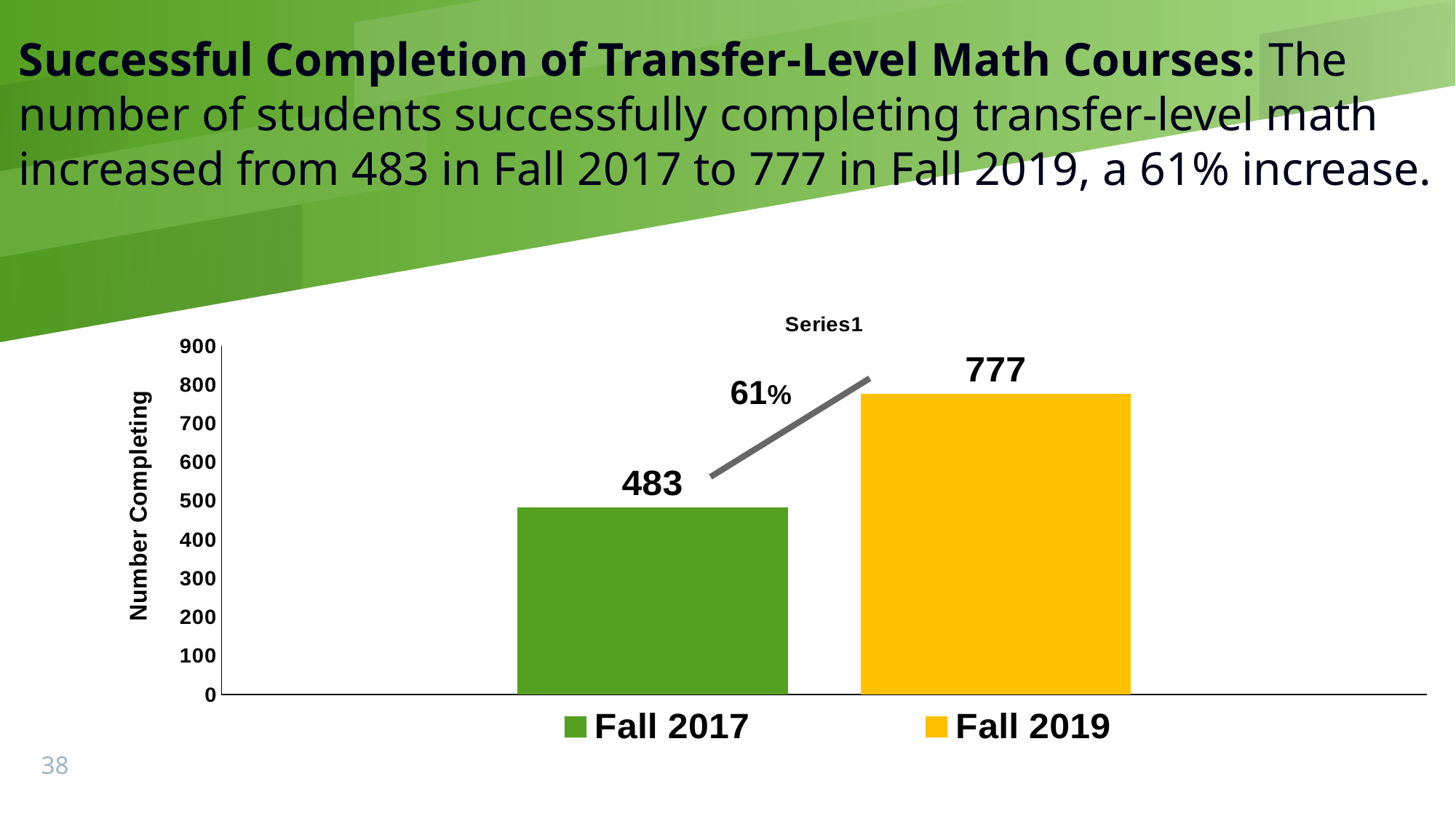
Which is larger, the value for Fall 2017 or Fall 2019? Fall 2019 Which category has the highest value? Fall 2019 How many bars are plotted in the chart? 2 What is the label of the vertical axis? Number Completing Is the value for Fall 2017 greater or less than 500? less Is the value for Fall 2019 greater or less than 700? greater What is the value for Fall 2019? 777 Which category has the lowest value? Fall 2017 What is the difference between the Fall 2019 and Fall 2017 values? 294 What kind of chart is shown on the slide? bar chart What percentage increase is annotated between the two bars? 61% What is the value for Fall 2017? 483